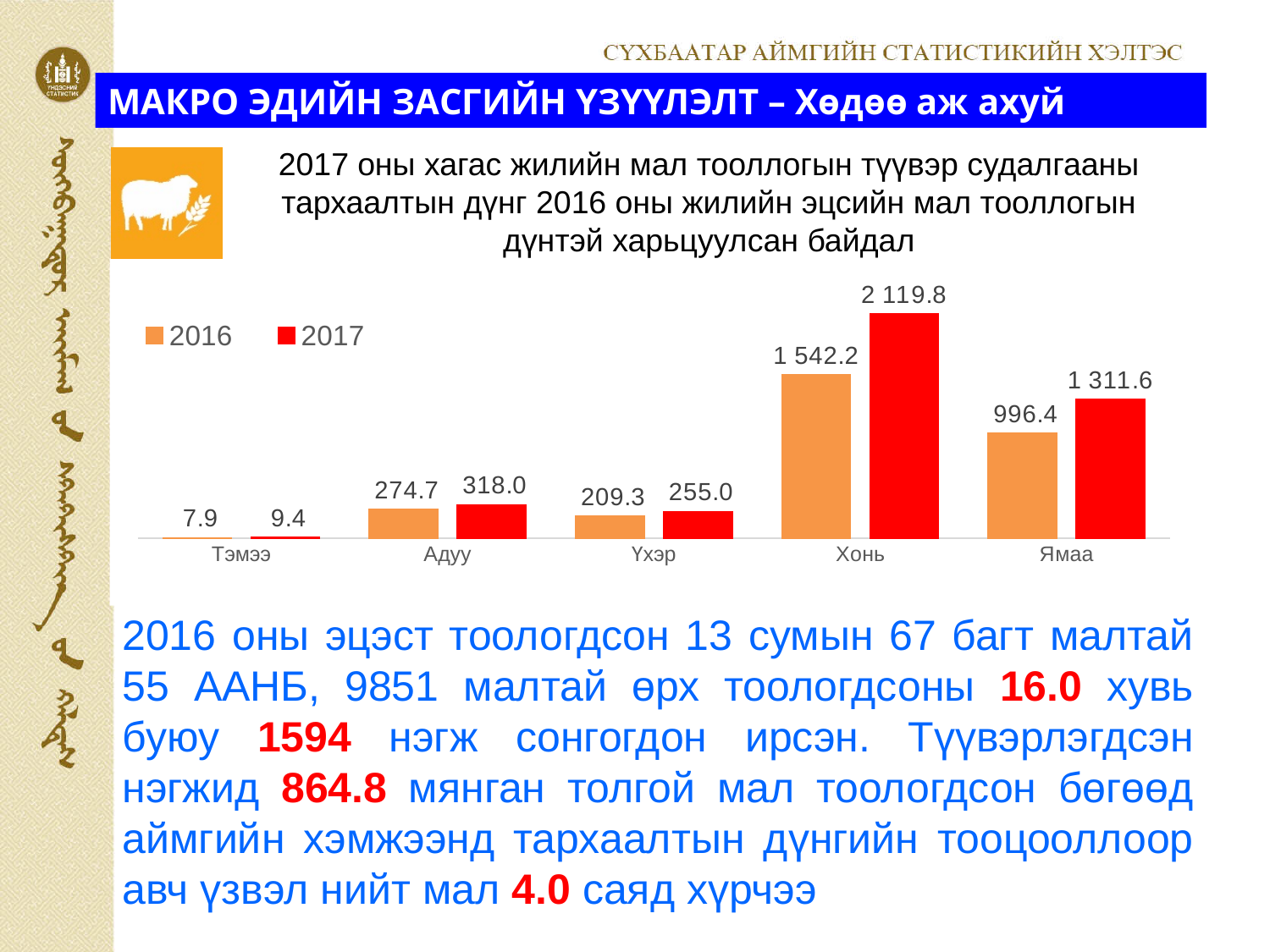
What is the 2016 value for Ямаа? 996.4 What is the 2017 value for Хонь? 2 119.8 What is the 2016 value for Адуу? 274.7 What is the 2017 value for Үхэр? 255.0 Which category has the lowest 2016 value? Тэмээ How many categories are shown on the x axis? 5 Which is larger, the 2016 value for Адуу or the 2016 value for Үхэр? Адуу Which category has the highest 2017 value? Хонь How many series does the legend list? 2 What is the difference between the 2017 and 2016 values for Хонь? 577.6 What is the difference between the 2017 and 2016 values for Ямаа? 315.2 What kind of chart is shown on the slide? Bar chart